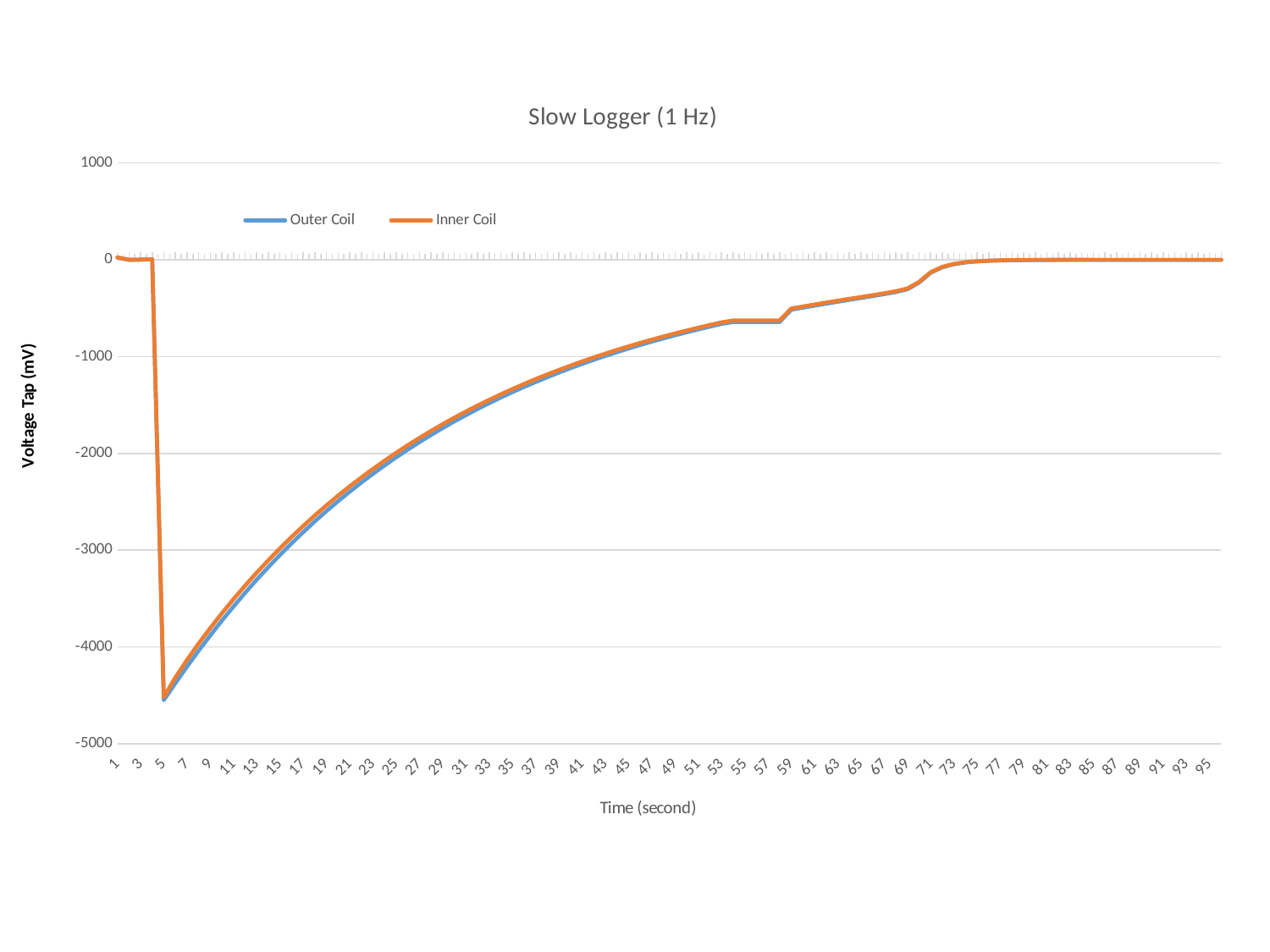
How many series does the legend list? 2 What is the lowest tick value shown on the y axis? -5000 Is the value for Inner Coil at time 55 greater or less than -1000? greater After the minimum at time 5, do the values rise or fall as time increases? rise What is the label of the y axis? Voltage Tap (mV) What kind of chart is shown on the slide? line chart What is the title of the chart? Slow Logger (1 Hz) Is the value for Outer Coil at time 35 greater or less than -2000? greater Is the value for Inner Coil at time 7 greater or less than -4000? less At which time label do both series reach their lowest value? 5 What is the last time label shown on the x axis? 95